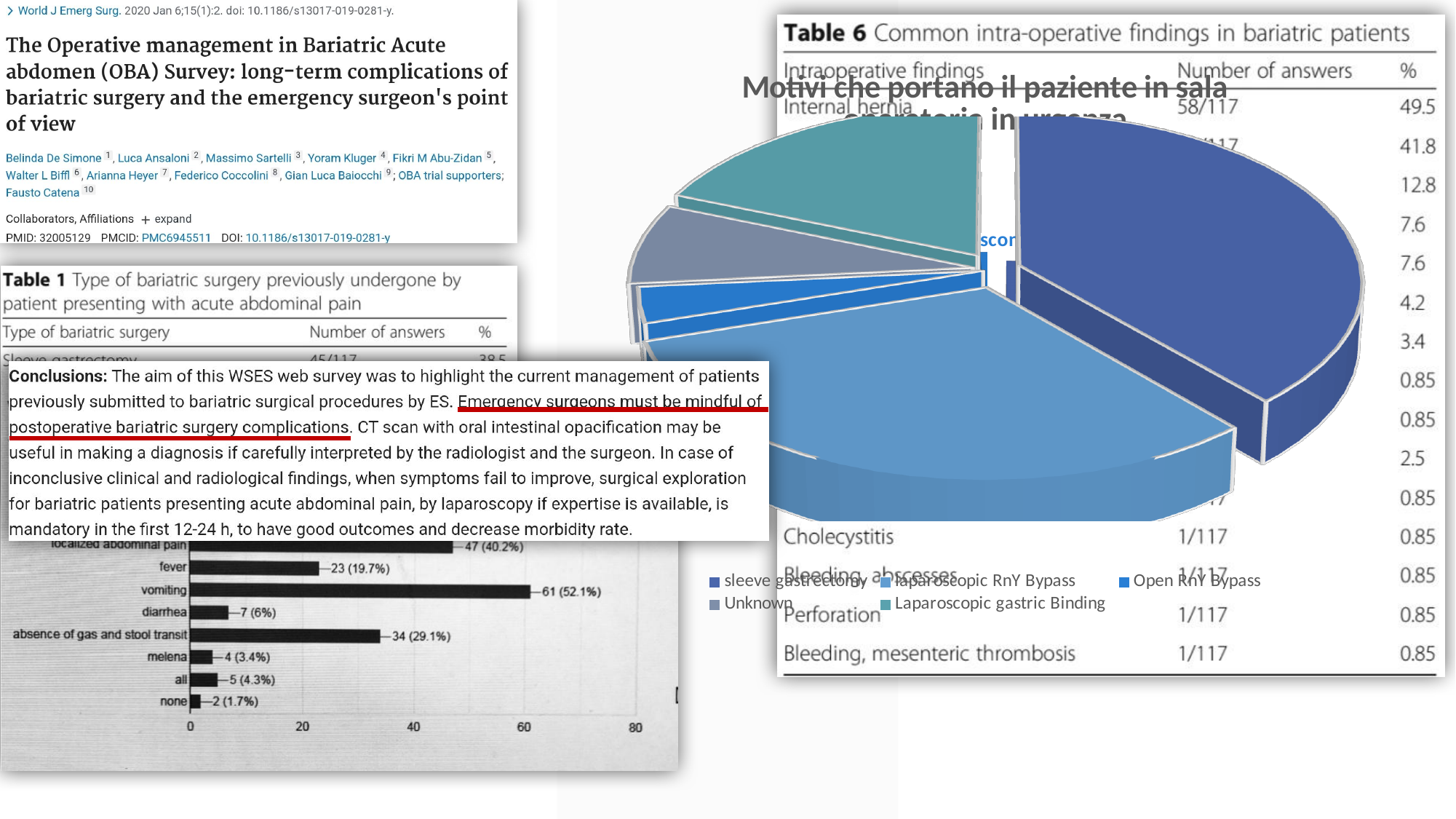
In the bar chart at the bottom left, which of the visible categories has the highest value? vomiting In the bar chart at the bottom left, which is larger: the value for diarrhea or the value for all? diarrhea In the pie chart on the right, which legend category has the smallest slice? Open RnY Bypass In the bar chart at the bottom left, what is the difference in count between vomiting and fever? 38 In the bar chart at the bottom left, what value is shown for vomiting? 61 (52.1%) In the bar chart at the bottom left, what value is shown for fever? 23 (19.7%) What kind of chart is the bottom-left chart showing symptoms such as fever and vomiting? bar chart In the bar chart at the bottom left, what value is shown for absence of gas and stool transit? 34 (29.1%) In the bar chart at the bottom left, which of the visible categories has the lowest value? none How many entries does the legend of the pie chart on the right list? 5 In the bar chart at the bottom left, is the value for localized abdominal pain greater or less than 40? greater In the bar chart at the bottom left, what value is shown for melena? 4 (3.4%)